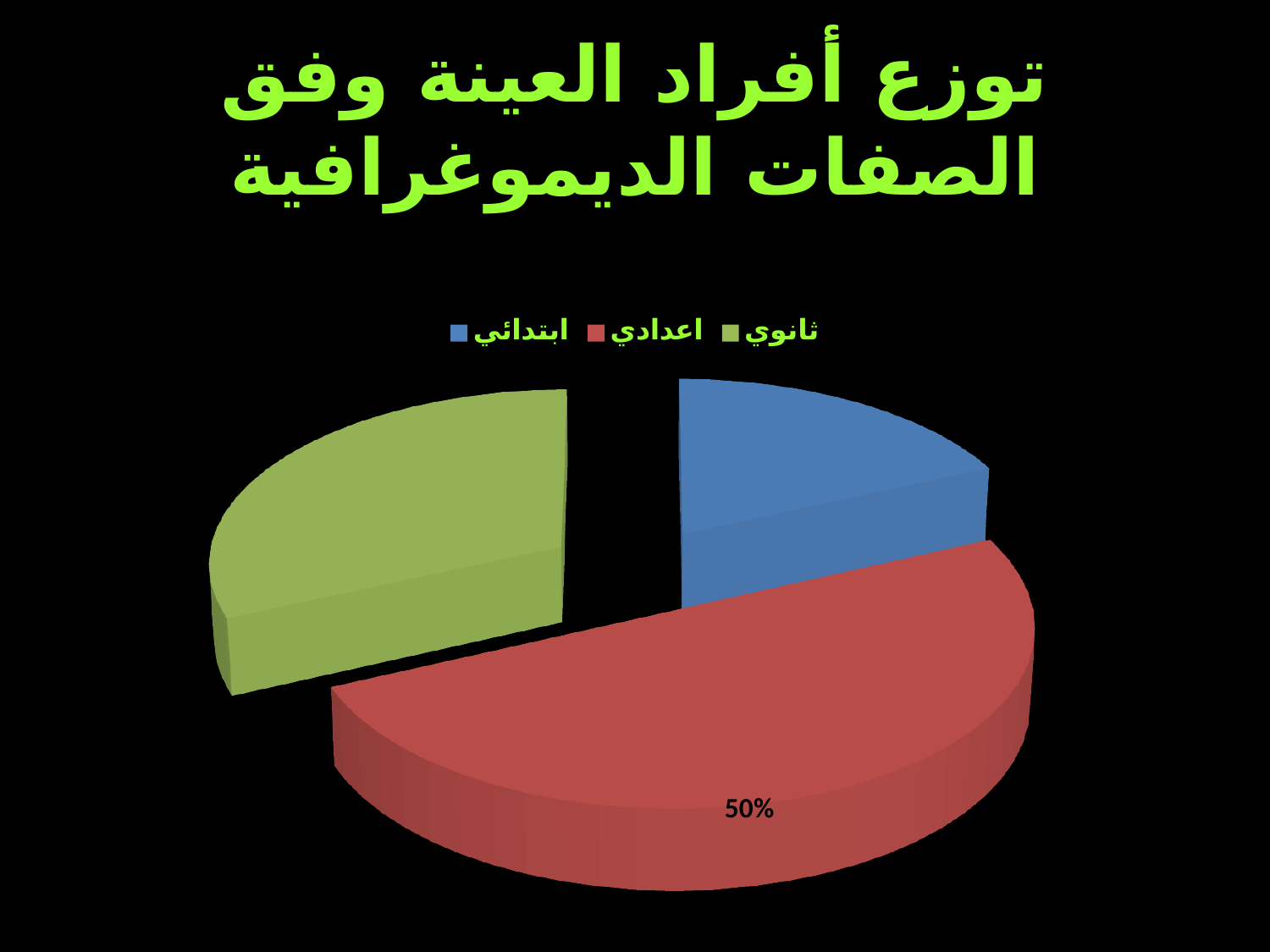
Which category has the smallest slice of the pie? ابتدائي Which slice is larger, ثانوي or ابتدائي? ثانوي Which slice is larger, اعدادي or ثانوي? اعدادي What percentage is shown for the اعدادي slice? 50% How many entries does the legend list? 3 How many slices does the pie chart have? 3 What colour is the اعدادي slice? red What kind of chart is shown on the slide? pie chart What share of the pie does the اعدادي slice represent? 50% Which category has the largest slice of the pie? اعدادي What is the title of the slide? توزع أفراد العينة وفق الصفات الديموغرافية